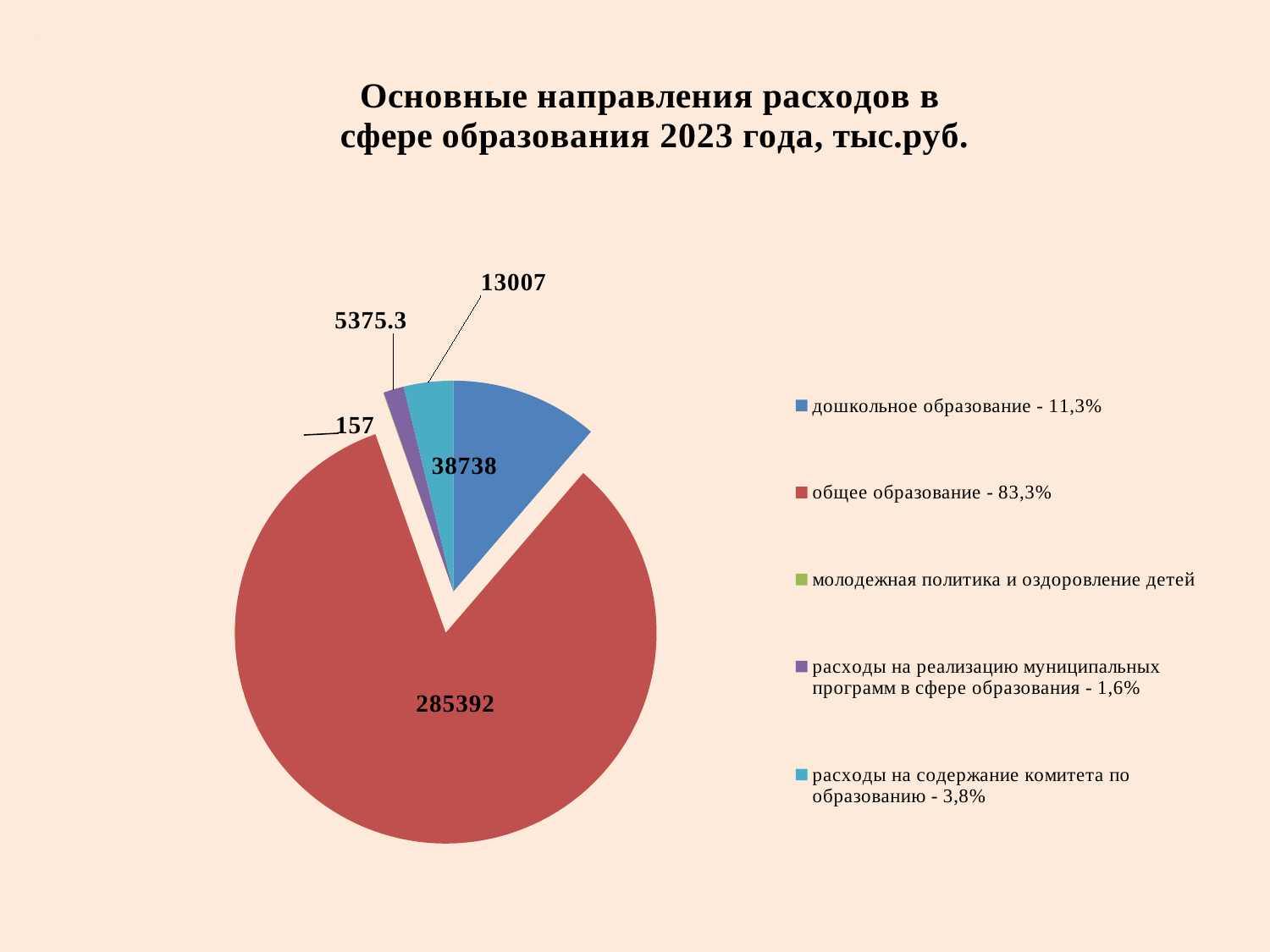
What is the value for молодежная политика и оздоровление детей? 157 Which category has the largest slice of the pie? общее образование Which is larger: the value for расходы на содержание комитета по образованию or the value for расходы на реализацию муниципальных программ в сфере образования? расходы на содержание комитета по образованию According to the legend, what share of the pie does общее образование represent? 83,3% What is the value for общее образование? 285392 What is the value for расходы на реализацию муниципальных программ в сфере образования? 5375.3 How many categories does the pie chart show? 5 What is the difference between the values for общее образование and дошкольное образование? 246654 What is the value for дошкольное образование? 38738 Which category has the smallest slice of the pie? молодежная политика и оздоровление детей What is the value for расходы на содержание комитета по образованию? 13007 What kind of chart is shown on the slide? pie chart